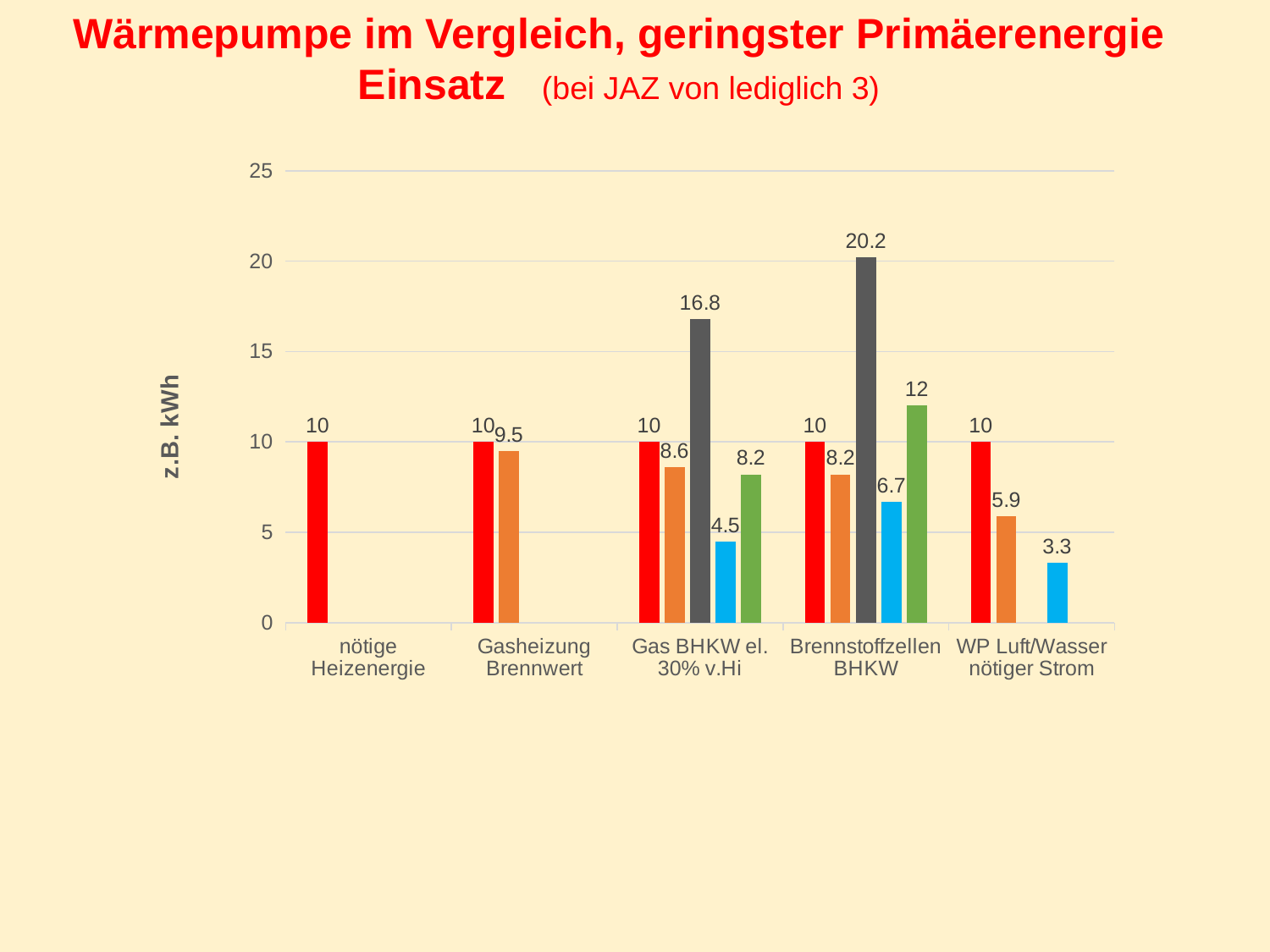
What is the value of the green bar for Gas BHKW el. 30% v.Hi? 8.2 Which category has the highest bar in the chart? Brennstoffzellen BHKW What is the label of the vertical axis? z.B. kWh What is the difference between the dark grey bars for Brennstoffzellen BHKW and Gas BHKW el. 30% v.Hi? 3.4 Which is larger: the blue bar for Brennstoffzellen BHKW or the blue bar for Gas BHKW el. 30% v.Hi? Brennstoffzellen BHKW What is the value of the orange bar for Gasheizung Brennwert? 9.5 What kind of chart is shown on the slide? bar chart How many categories are shown on the x axis? 5 Which category has the lowest bar in the chart? WP Luft/Wasser nötiger Strom What is the value of the blue bar for WP Luft/Wasser nötiger Strom? 3.3 Is the green bar for Brennstoffzellen BHKW greater or less than 10? greater What is the value of the dark grey bar for Brennstoffzellen BHKW? 20.2